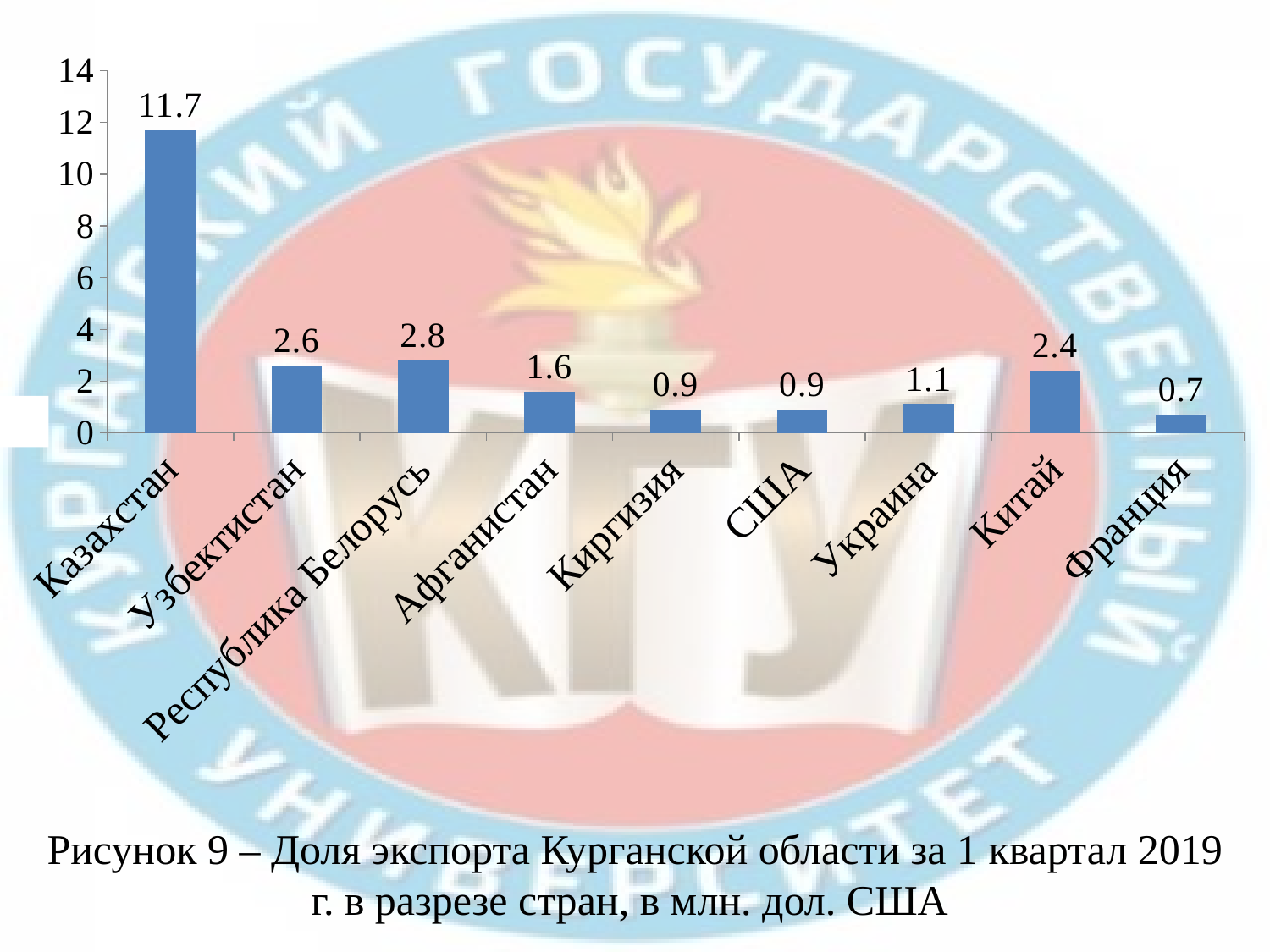
What is the value for Казахстан? 11.7 What unit of measurement is stated in the caption below the chart? млн. дол. США Which country has the lowest value? Франция Which is larger, the value for Афганистан or the value for Украина? Афганистан What is the value for Китай? 2.4 What is the difference between the values for Казахстан and Узбекистан? 9.1 Which country has the highest value? Казахстан What is the difference between the values for Республика Беларусь and Китай? 0.4 Is the value for Казахстан greater or less than 10? greater How many countries are shown on the chart? 9 What kind of chart is shown on the slide? bar chart What is the value for Республика Беларусь? 2.8